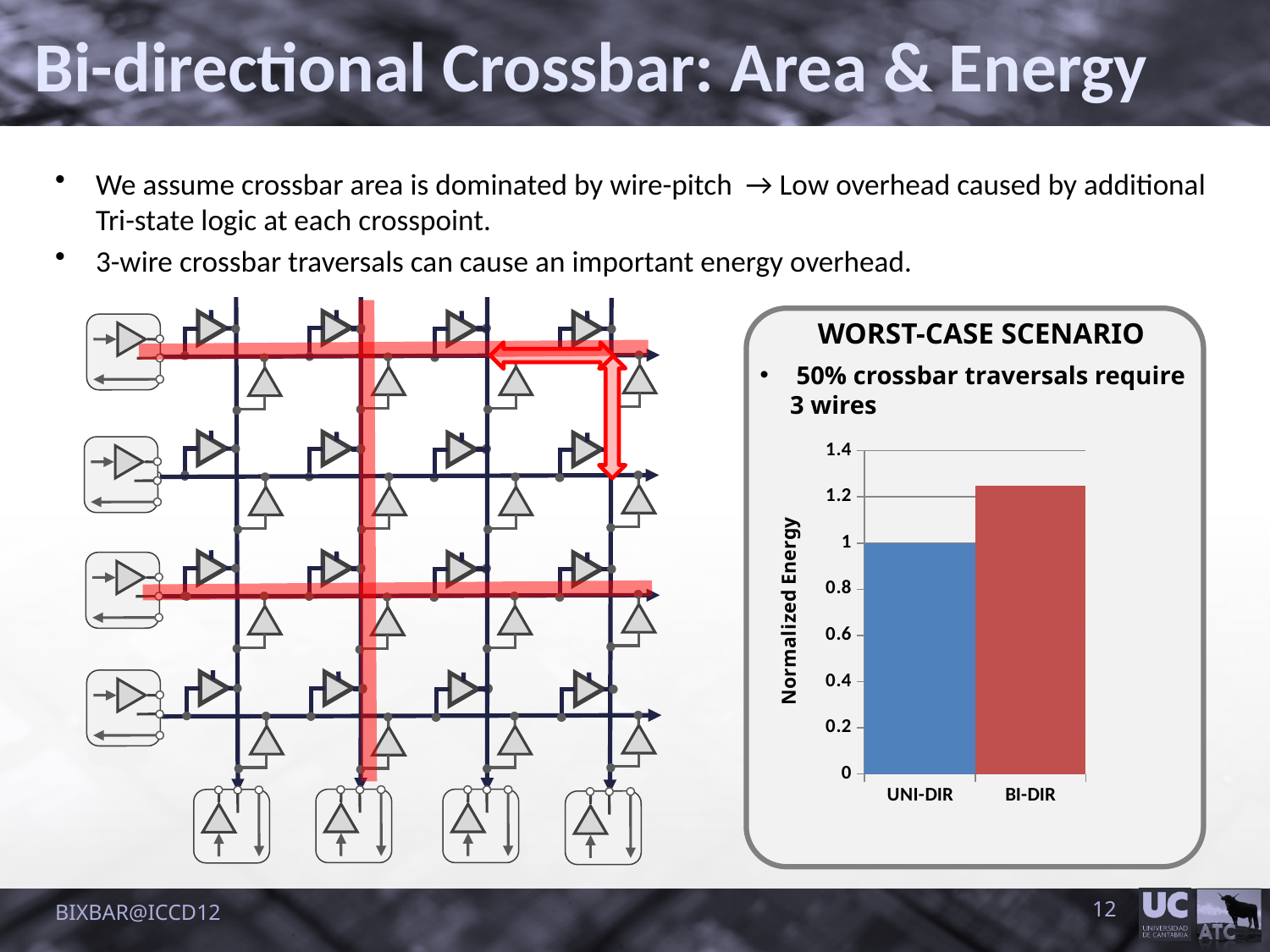
What type of chart is shown on the slide? bar chart Is the normalized energy for BI-DIR greater or less than 1? greater Is the normalized energy for UNI-DIR greater or less than 1.2? less What colour is the BI-DIR bar in the chart? red Which has a larger normalized energy, UNI-DIR or BI-DIR? BI-DIR What is the normalized energy value for UNI-DIR? 1 What is the label of the vertical axis of the chart? Normalized Energy Which category has the highest normalized energy? BI-DIR Is the normalized energy for BI-DIR greater or less than 1.4? less Which category has the lowest normalized energy? UNI-DIR How many categories are plotted in the bar chart? 2